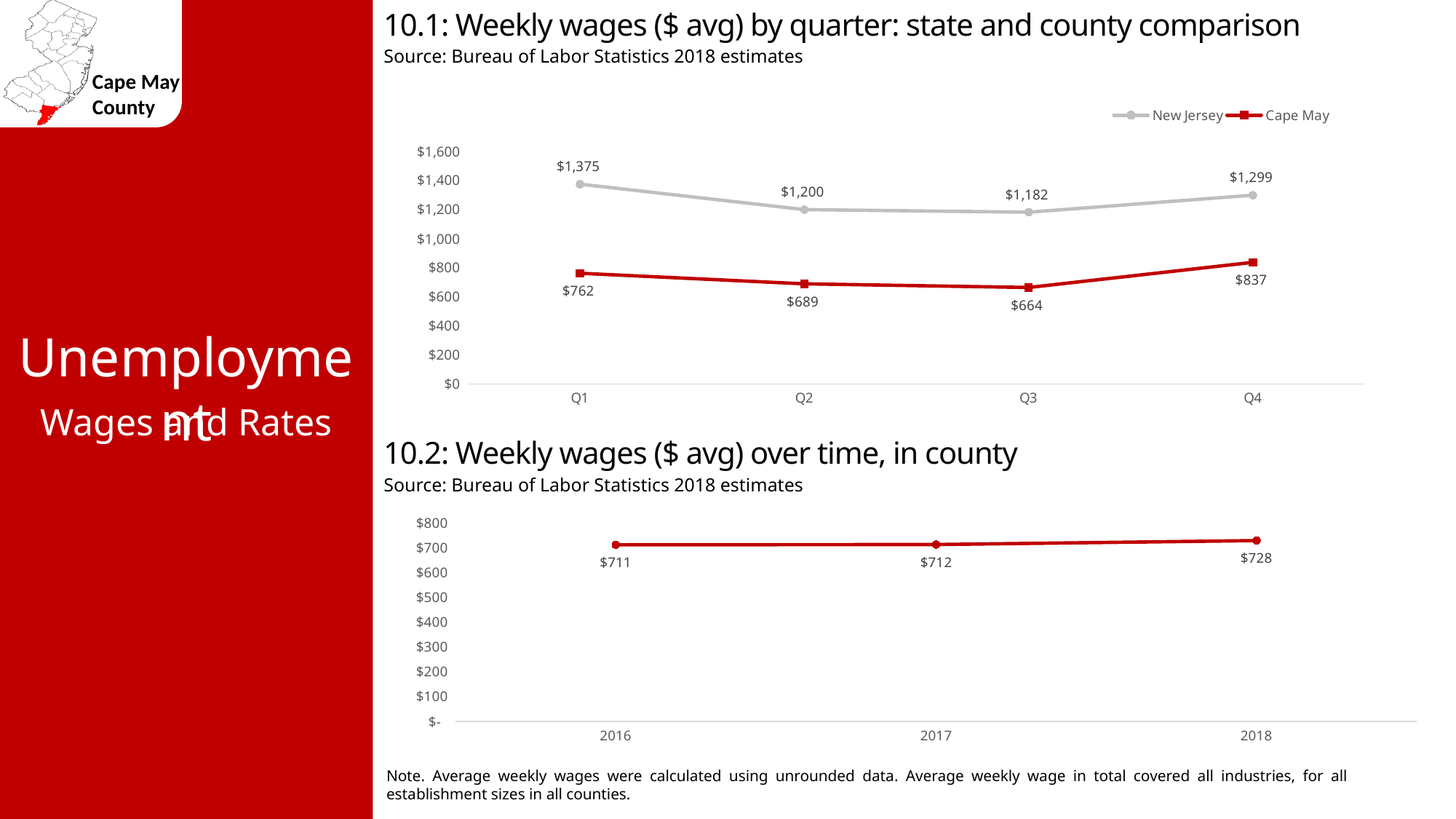
In chart 10.1 (state and county comparison), what type of chart is shown? Line chart In chart 10.2 (weekly wages over time, in county), do the values rise or fall from 2016 to 2018? Rise In chart 10.2 (weekly wages over time, in county), how many years are plotted? 3 In chart 10.1 (state and county comparison), what is the New Jersey weekly wage in Q1? $1,375 In chart 10.1 (state and county comparison), what is the difference between the New Jersey and Cape May weekly wages in Q4? $462 In chart 10.1 (state and county comparison), how many series does the legend list? 2 In chart 10.2 (weekly wages over time, in county), what is the weekly wage in 2017? $712 In chart 10.1 (state and county comparison), in which quarter is the Cape May weekly wage highest? Q4 In chart 10.1 (state and county comparison), which series has the higher weekly wage in Q2, New Jersey or Cape May? New Jersey In chart 10.1 (state and county comparison), in which quarter is the New Jersey weekly wage lowest? Q3 In chart 10.2 (weekly wages over time, in county), what is the difference between the 2018 and 2016 weekly wages? $17 In chart 10.1 (state and county comparison), what is the Cape May weekly wage in Q3? $664